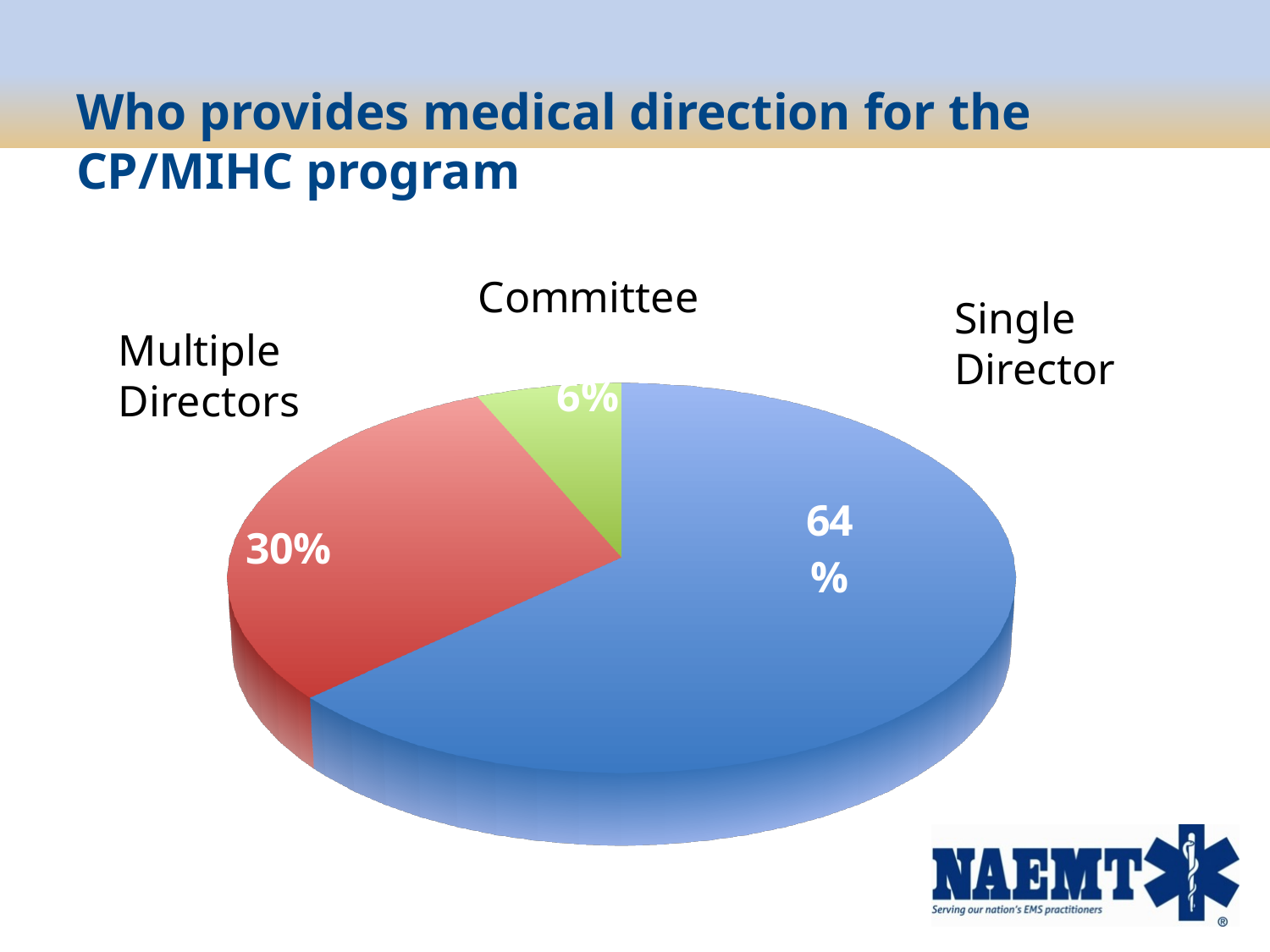
Which is larger, the share for Multiple Directors or the share for Committee? Multiple Directors What percentage of the pie is Single Director? 64% What colour is the Single Director slice? Blue How many categories are shown in the pie chart? 3 What is the difference in percentage points between Multiple Directors and Committee? 24 Which category has the smallest share of the pie? Committee What percentage of the pie is Committee? 6% What is the title of the slide containing the chart? Who provides medical direction for the CP/MIHC program What percentage of the pie is Multiple Directors? 30% Which category has the largest share of the pie? Single Director What is the difference in percentage points between Single Director and Multiple Directors? 34 What kind of chart is shown on the slide? Pie chart